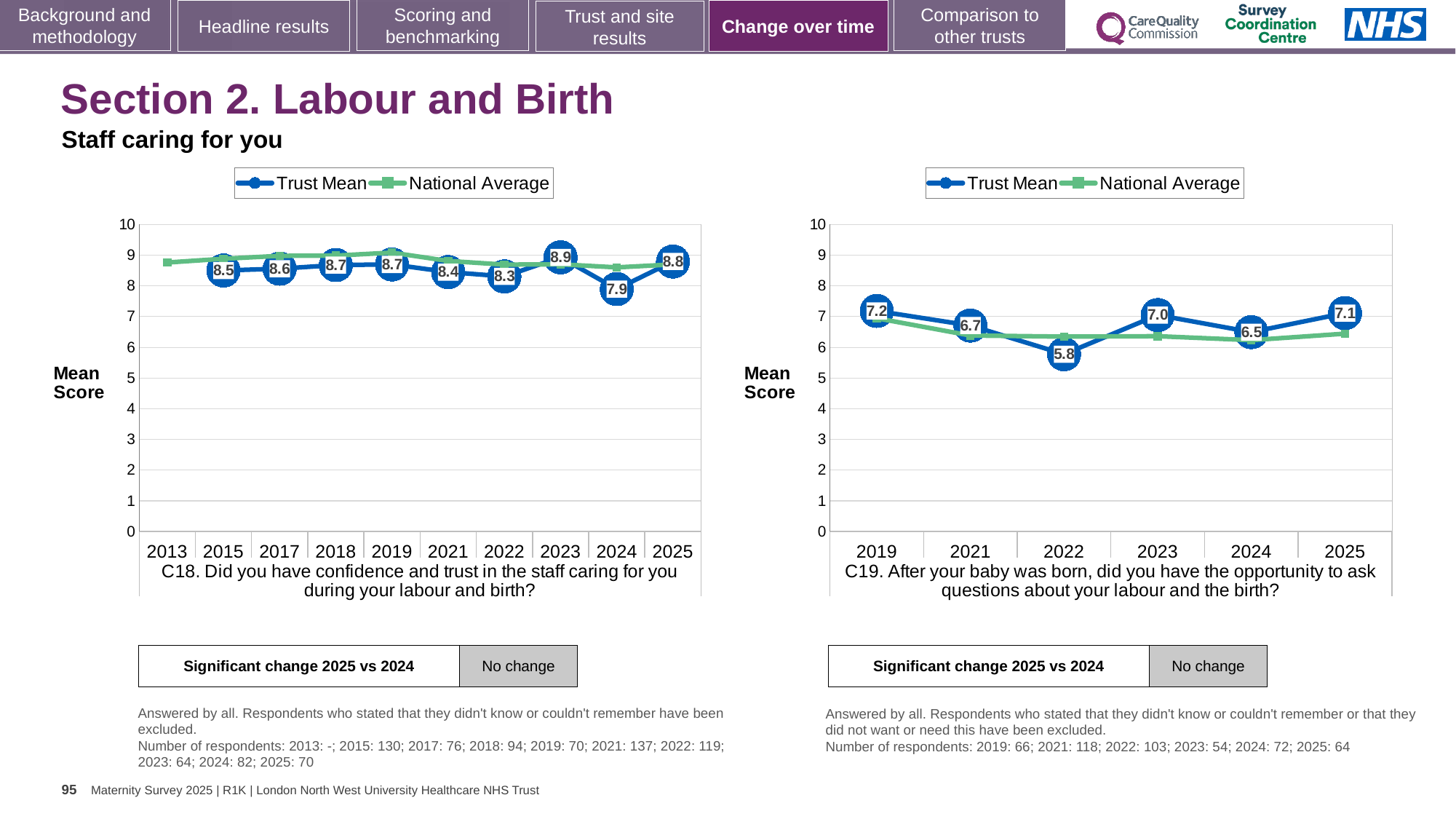
In the C18 chart (left), what is the difference between the Trust Mean for 2023 and 2024? 1.0 How many series does the legend of the C18 chart (left) list? 2 In the C19 chart (right), is the Trust Mean for 2021 larger or smaller than the Trust Mean for 2024? larger In the C19 chart (right), is the National Average for 2022 greater or less than 7? less In the C19 chart (right), which year has the lowest Trust Mean? 2022 In the C19 chart (right), what is the Trust Mean for 2022? 5.8 How many years are shown on the x axis of the C19 chart (right)? 6 In the C18 chart (left), which year has the lowest Trust Mean? 2024 In the C18 chart (left), what is the Trust Mean for 2025? 8.8 In the C18 chart (left), what is the Trust Mean for 2024? 7.9 In the C18 chart (left), which year has the highest Trust Mean? 2023 In the C19 chart (right), which year has the highest Trust Mean? 2019